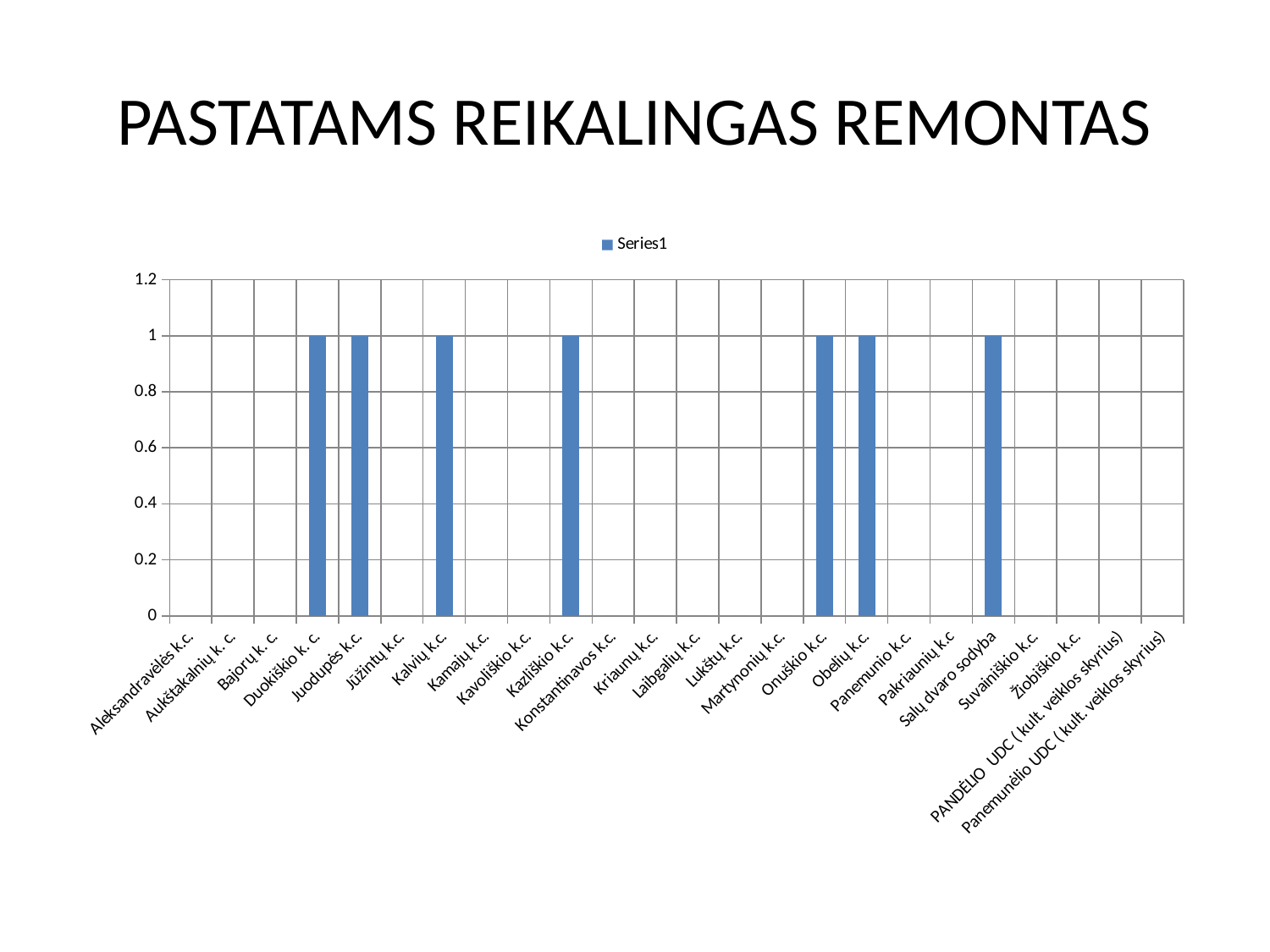
How many series does the legend list? 1 How many categories are shown on the x axis? 24 What is the name of the series in the legend? Series1 What is the value for Duokiškio k. c.? 1 What is the value for Salų dvaro sodyba? 1 Which is larger, the value for Obelių k.c. or the value for Panemunio k.c.? Obelių k.c. What kind of chart is shown on the slide? bar chart What is the value for Kamajų k.c.? 0 What is the title of the slide? PASTATAMS REIKALINGAS REMONTAS How many categories have a bar with a value of 1? 7 What is the difference between the value for Juodupės k.c. and the value for Jūžintų k.c.? 1 What is the value for Kazliškio k.c.? 1